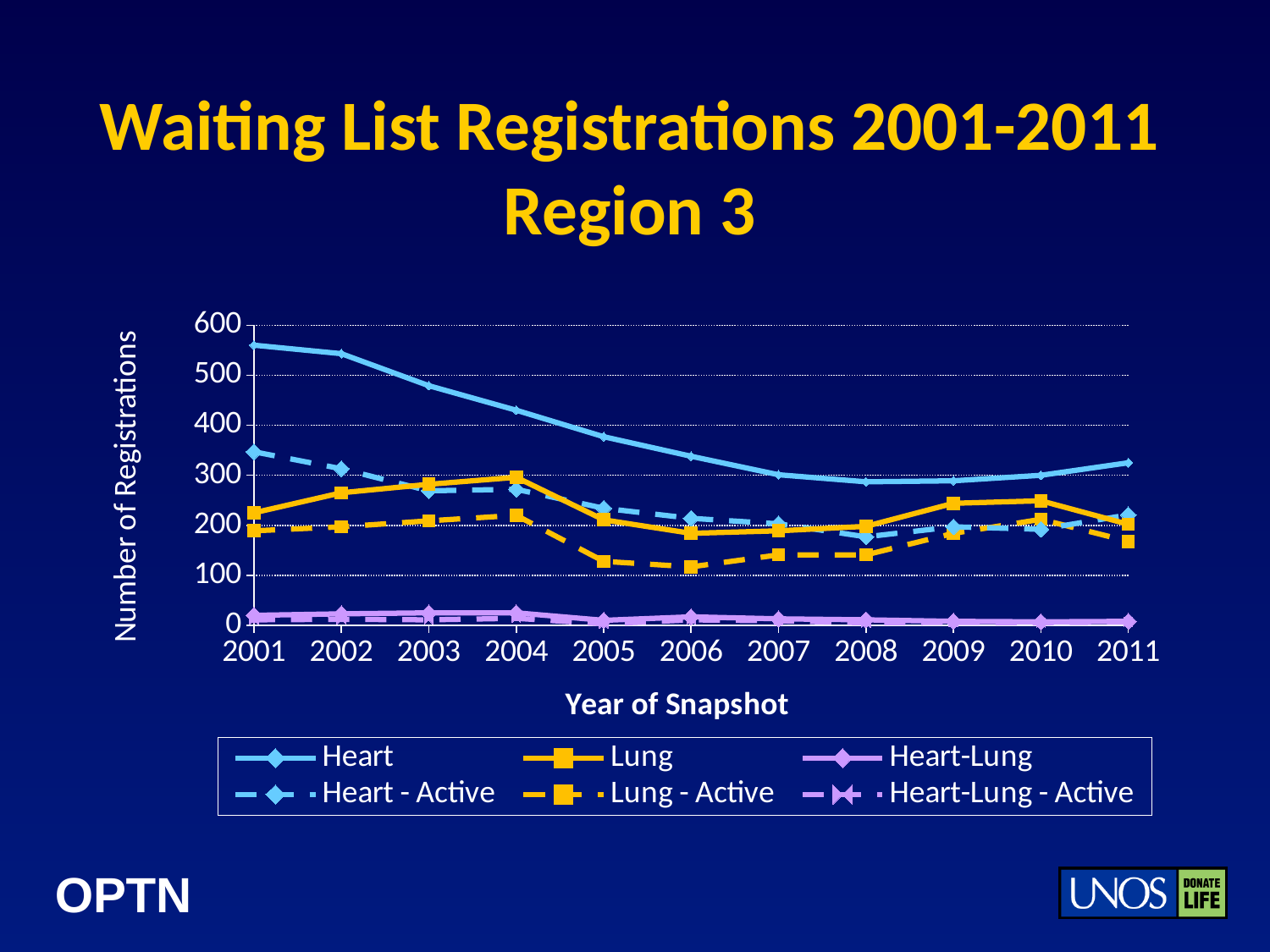
How many years are plotted along the x axis? 11 In 2005, which is larger: Lung or Lung - Active? Lung What is the label of the y axis? Number of Registrations Is the value for Lung in 2006 greater or less than 200? less How many series does the legend list? 6 Is the value for Heart in 2001 greater or less than 500? greater Which series has the lowest values across all years? Heart-Lung - Active What kind of chart is shown on the slide? line chart Does the Heart series rise or fall from 2001 to 2008? fall In which year is the Heart series at its highest? 2001 Is the value for Heart in 2011 greater or less than 300? greater